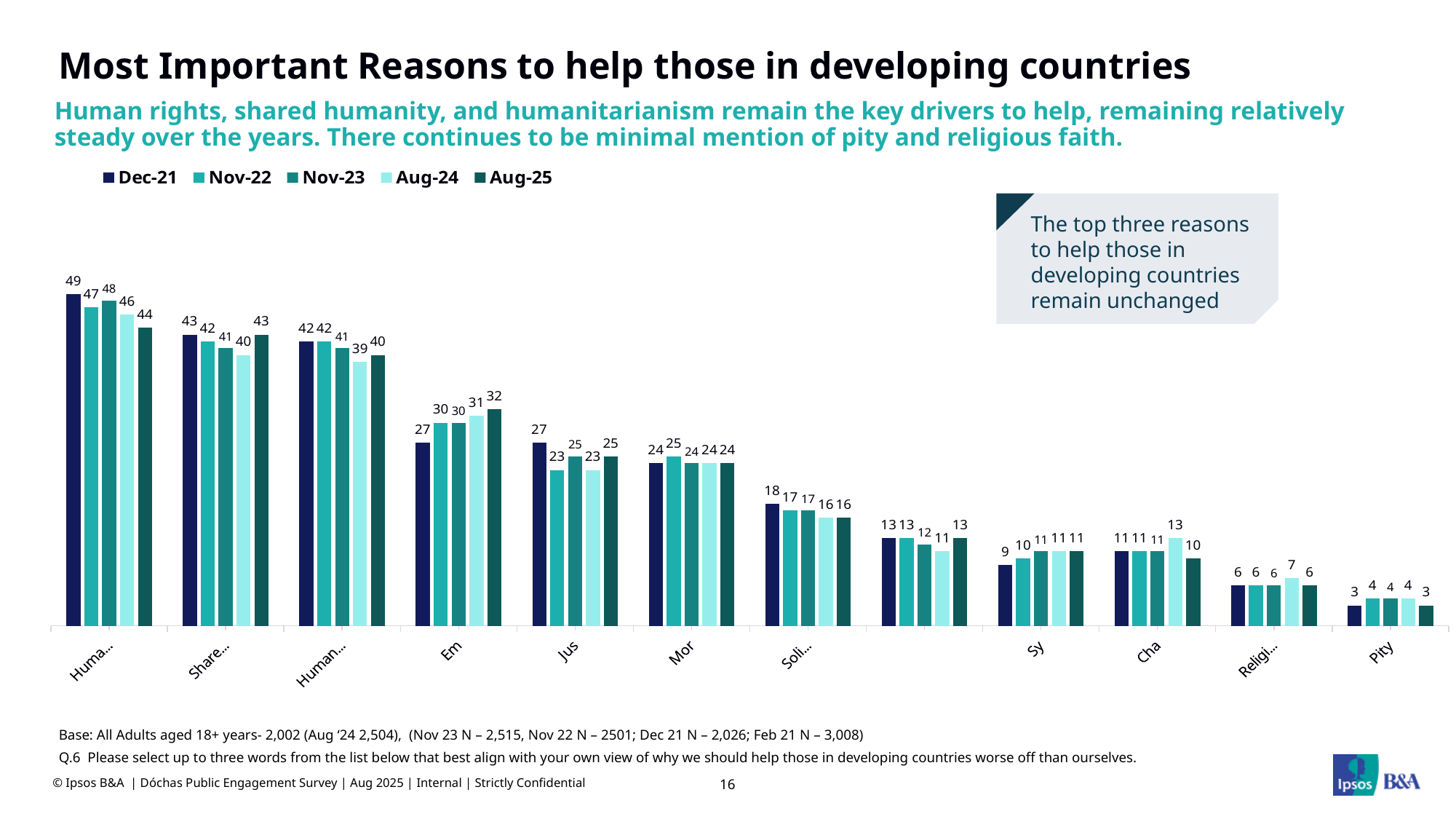
What is the Aug-25 value for Pity? 3 Which category has the lowest values across all series? Pity How many categories are plotted along the x axis? 12 What is the Aug-24 value for Pity? 4 How many series does the legend list? 5 What is the Dec-21 value for the leftmost category? 49 For Pity, which is larger: the Nov-22 value or the Aug-25 value? Nov-22 What is the difference between the Dec-21 and Aug-25 values for the leftmost category? 5 What is the first entry in the chart legend? Dec-21 For the leftmost category, which series has the highest value? Dec-21 What is the difference between the Nov-22 and Dec-21 values for Pity? 1 What kind of chart is shown on the slide? bar chart